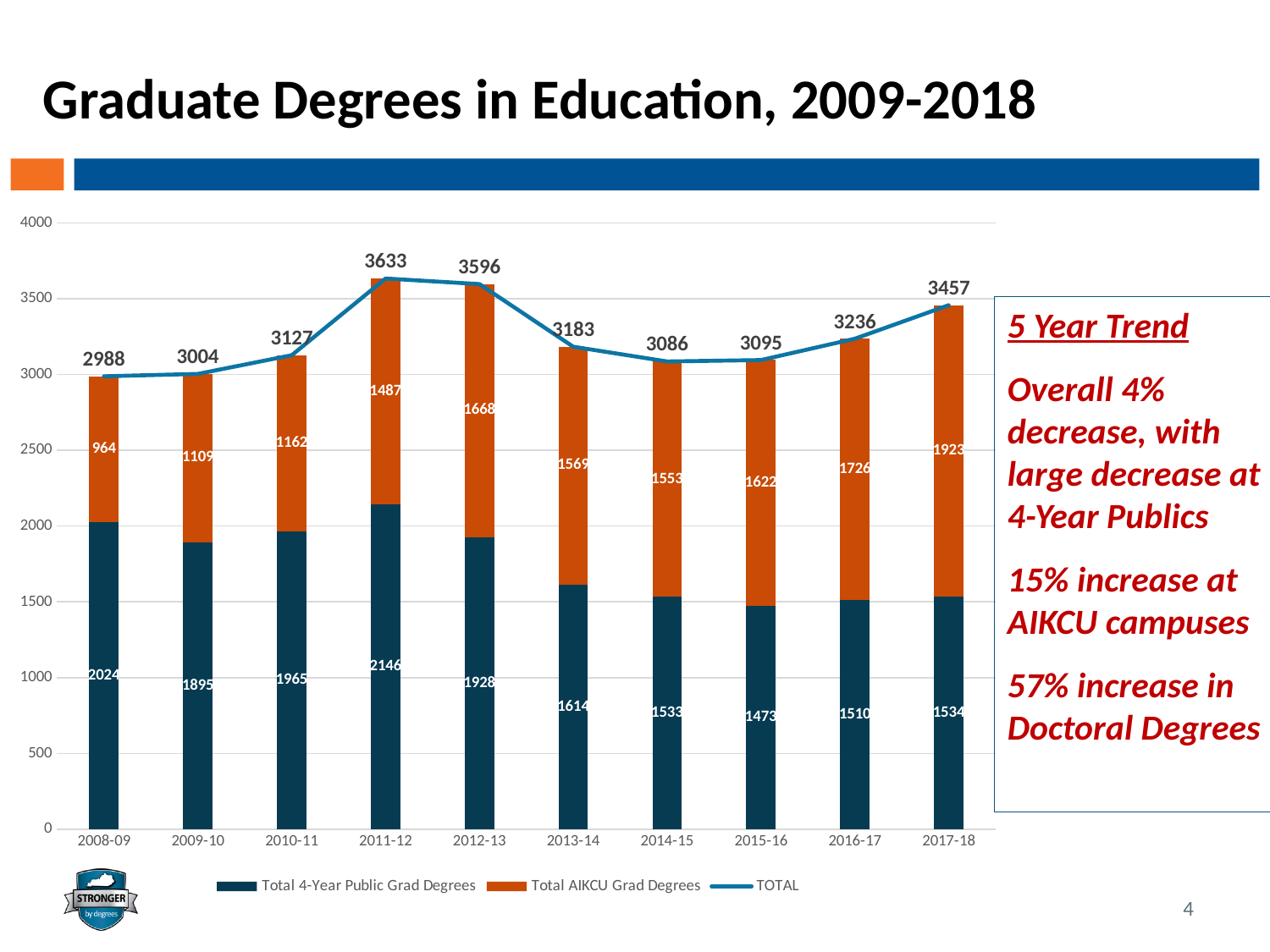
What is the TOTAL value for 2011-12? 3633 How many Total AIKCU Grad Degrees were there in 2017-18? 1923 Which year has the lowest TOTAL value? 2008-09 What is the difference between the TOTAL values for 2011-12 and 2012-13? 37 How many academic years are shown on the x axis? 10 How many Total 4-Year Public Grad Degrees were there in 2015-16? 1473 Does the TOTAL value rise or fall from 2014-15 to 2017-18? Rise Which is larger in 2014-15: Total 4-Year Public Grad Degrees or Total AIKCU Grad Degrees? Total AIKCU Grad Degrees Which year has the highest TOTAL value? 2011-12 What is the title of the slide? Graduate Degrees in Education, 2009-2018 How many series does the legend list? 3 What kind of chart is shown on the slide? Stacked bar chart with a line